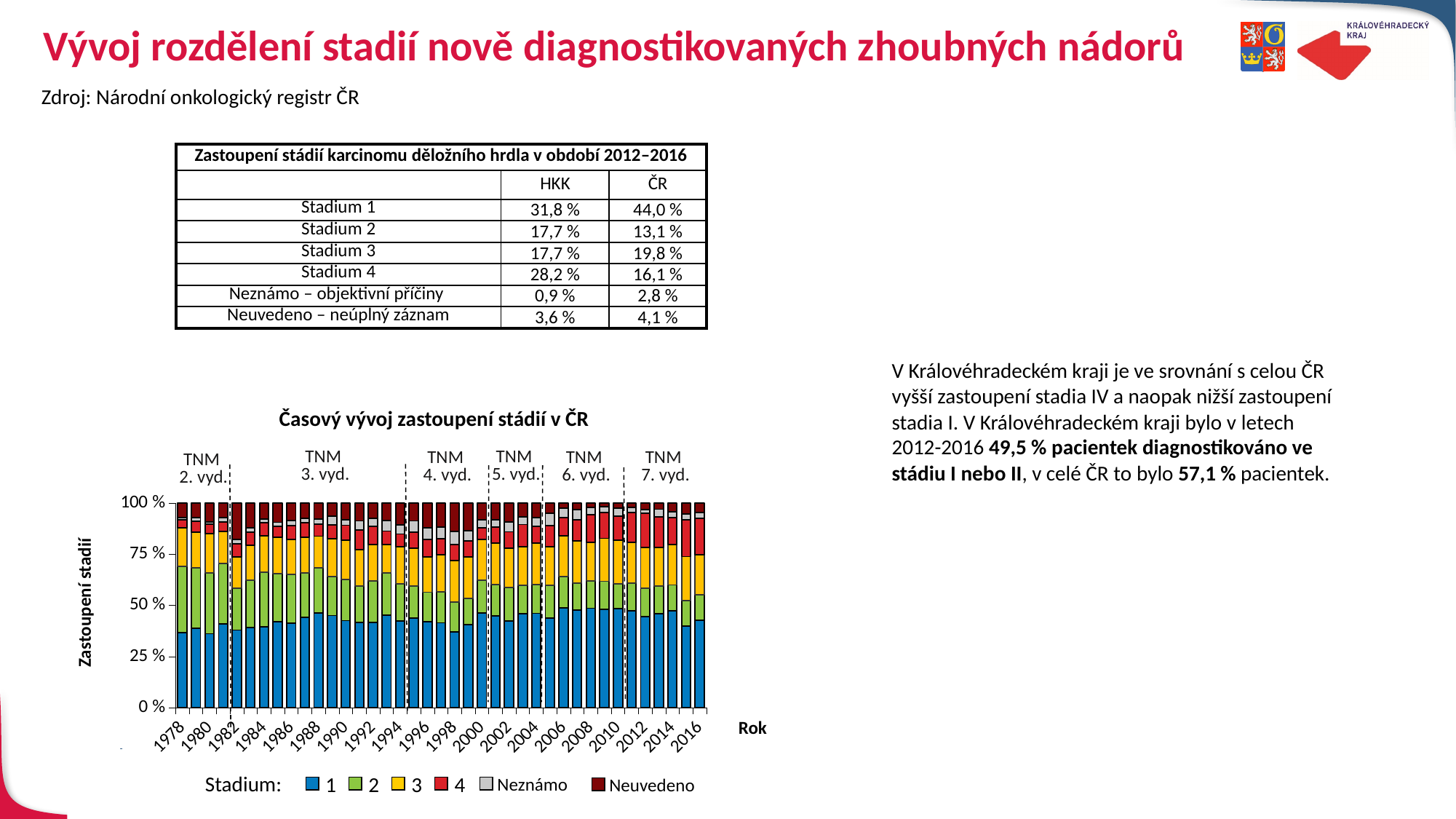
What kind of chart is 'Časový vývoj zastoupení stádií v ČR'? stacked bar chart How many series does the legend of the chart 'Časový vývoj zastoupení stádií v ČR' list? 6 How many years are labelled on the x axis of the chart 'Časový vývoj zastoupení stádií v ČR'? 20 In the chart 'Časový vývoj zastoupení stádií v ČR', is the share of Stadium 1 in 2016 greater or less than 50 %? less In the chart 'Časový vývoj zastoupení stádií v ČR', is the share of Stadium 1 in 1978 greater or less than 25 %? greater In the chart 'Časový vývoj zastoupení stádií v ČR', is the share of Stadium 1 larger in 1978 or in 1988? 1988 In the chart 'Časový vývoj zastoupení stádií v ČR', what is the total of each stacked bar? 100 % What is the label of the x axis of the chart 'Časový vývoj zastoupení stádií v ČR'? Rok In the chart 'Časový vývoj zastoupení stádií v ČR', does the share of Stadium 2 rise or fall between 1978 and 2016? fall In the chart 'Časový vývoj zastoupení stádií v ČR', which colour represents Stadium 1 in the legend? blue In the chart 'Časový vývoj zastoupení stádií v ČR', is the share of Stadium 1 in 1978 greater or less than 50 %? less